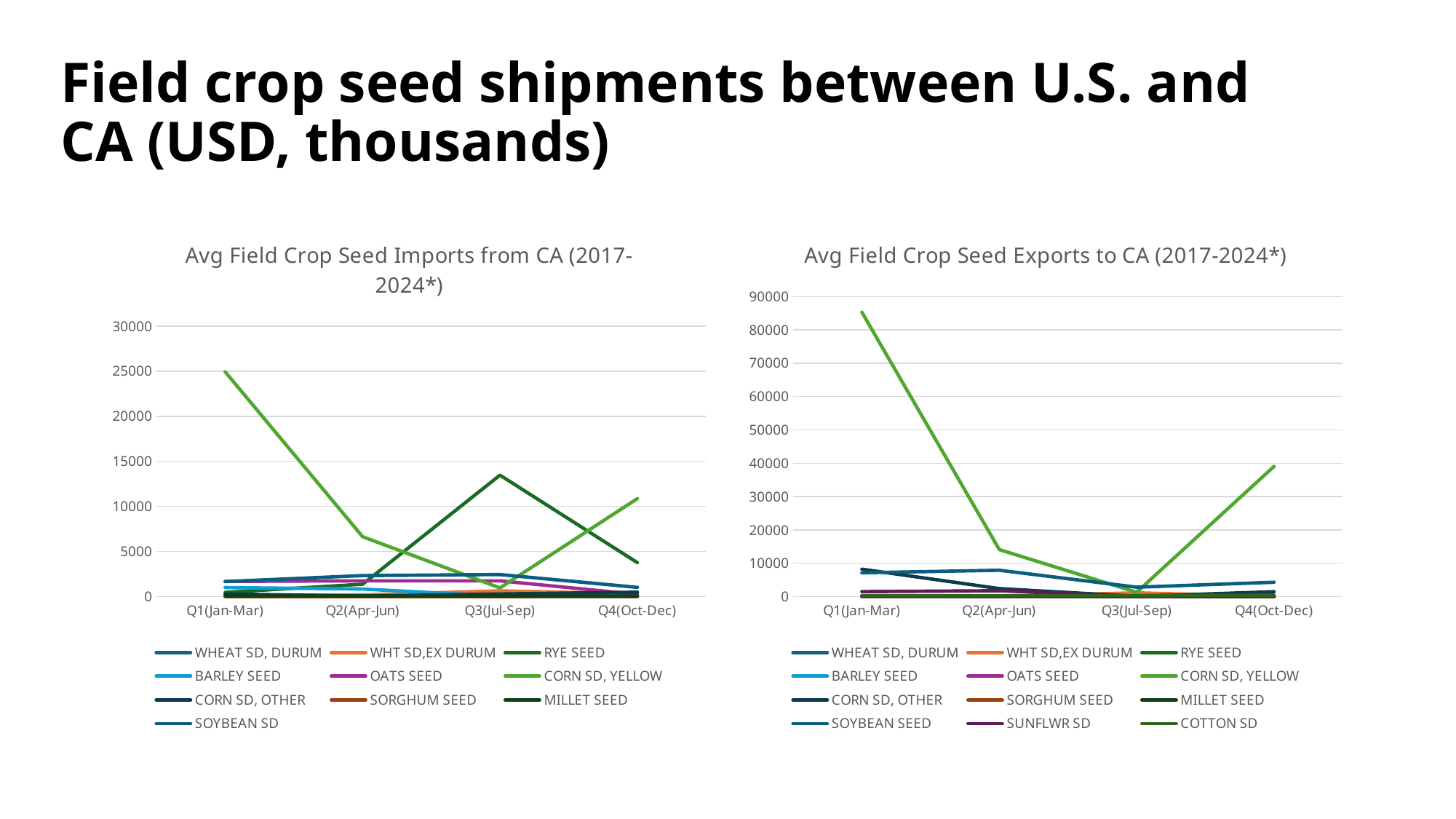
In the 'Avg Field Crop Seed Exports to CA (2017-2024*)' chart, is the value for CORN SD, YELLOW at Q4(Oct-Dec) greater or less than 30000? greater In the 'Avg Field Crop Seed Imports from CA (2017-2024*)' chart, which series has the highest value at Q3(Jul-Sep)? RYE SEED How many series does the legend of the 'Avg Field Crop Seed Exports to CA (2017-2024*)' chart list? 12 What type of chart is the 'Avg Field Crop Seed Imports from CA (2017-2024*)' chart? line chart How many quarters are shown on the x axis of the 'Avg Field Crop Seed Exports to CA (2017-2024*)' chart? 4 How many series does the legend of the 'Avg Field Crop Seed Imports from CA (2017-2024*)' chart list? 10 In the 'Avg Field Crop Seed Imports from CA (2017-2024*)' chart, is the value for RYE SEED at Q3(Jul-Sep) greater or less than 10000? greater In the 'Avg Field Crop Seed Exports to CA (2017-2024*)' chart, which is larger at Q1(Jan-Mar): CORN SD, YELLOW or WHEAT SD, DURUM? CORN SD, YELLOW In the 'Avg Field Crop Seed Imports from CA (2017-2024*)' chart, in which quarter is CORN SD, YELLOW highest? Q1(Jan-Mar) In the 'Avg Field Crop Seed Imports from CA (2017-2024*)' chart, is the value for CORN SD, YELLOW at Q1(Jan-Mar) greater or less than 20000? greater In the 'Avg Field Crop Seed Exports to CA (2017-2024*)' chart, does the CORN SD, YELLOW line rise or fall from Q1(Jan-Mar) to Q3(Jul-Sep)? fall